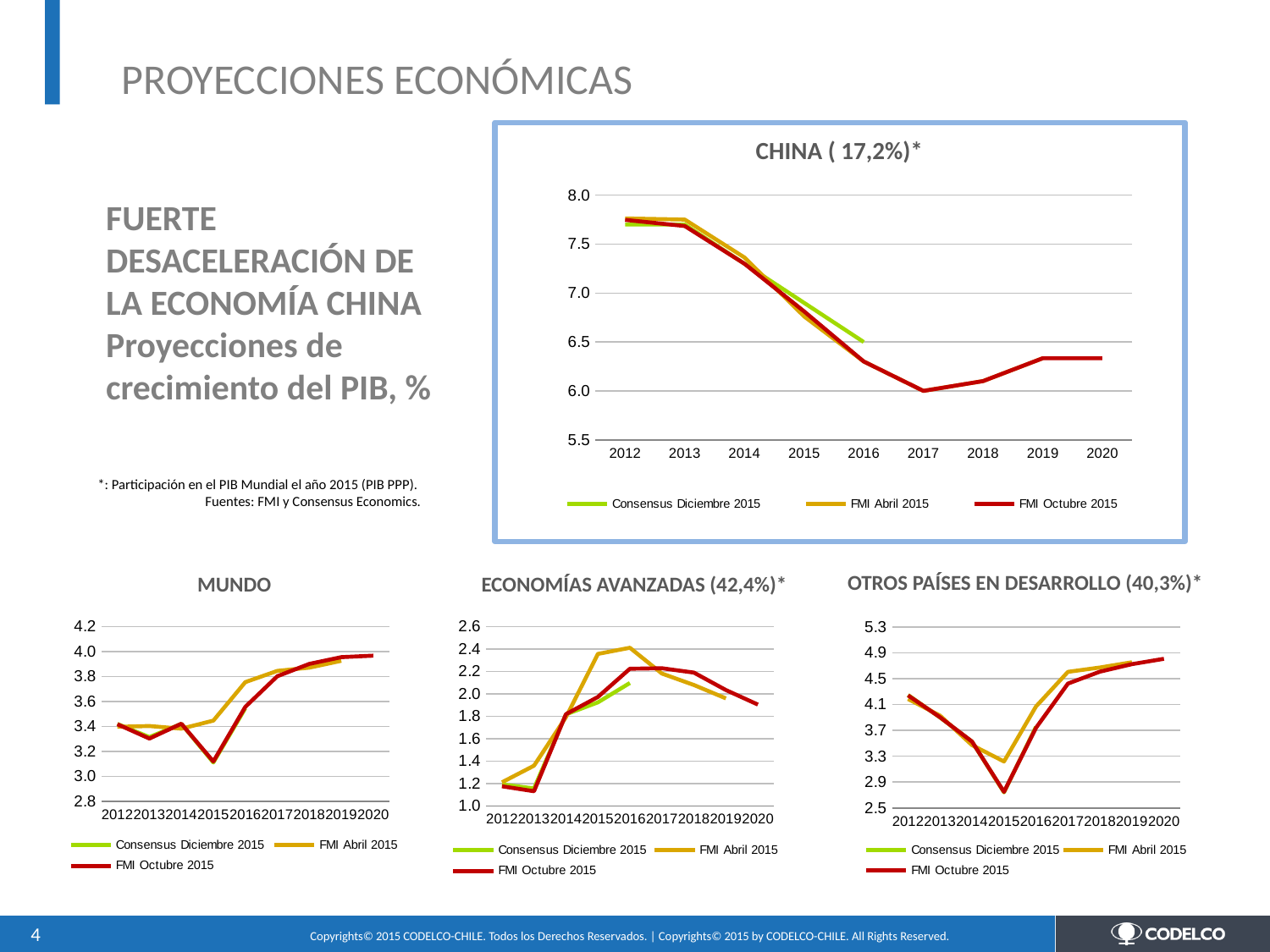
What is the title of the chart at the bottom left of the slide? MUNDO In the ECONOMÍAS AVANZADAS (42,4%)* chart, is the FMI Abril 2015 value for 2016 greater or less than 2.2? greater How many series does the legend of the CHINA ( 17,2%)* chart list? 3 In the OTROS PAÍSES EN DESARROLLO (40,3%)* chart, is the FMI Octubre 2015 value for 2015 greater or less than 2.9? less In the MUNDO chart, is the FMI Octubre 2015 value for 2015 greater or less than 3.4? less In the CHINA ( 17,2%)* chart, do the FMI Octubre 2015 values rise or fall from 2012 to 2017? fall How many years are shown on the x axis of the CHINA ( 17,2%)* chart? 9 What kind of chart is the CHINA ( 17,2%)* chart? line chart In the OTROS PAÍSES EN DESARROLLO (40,3%)* chart, do the FMI Octubre 2015 values rise or fall from 2015 to 2020? rise